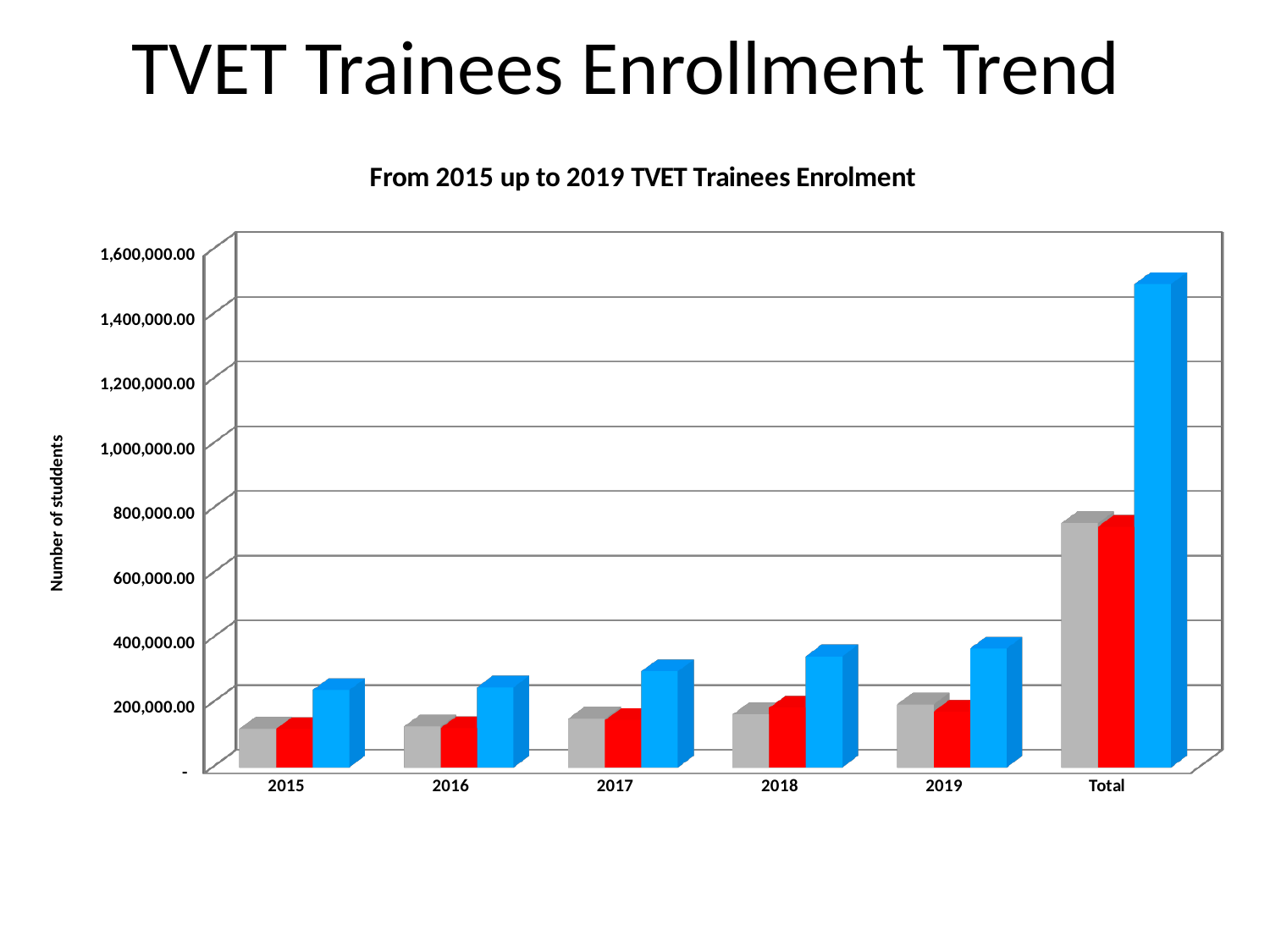
Is the value of the gray bar for 2015 greater or less than 200,000.00? less How many bars are plotted for each category on the chart? 3 How many categories are shown along the x axis of the chart? 6 What kind of chart is shown on the slide? bar chart Do the blue bars rise or fall from 2015 to 2019? rise What is the label on the vertical axis of the chart? Number of studdents Among the years 2015 to 2019, which year has the tallest blue bar? 2019 Is the value of the gray bar for Total greater or less than 600,000.00? greater What is the title of the chart? From 2015 up to 2019 TVET Trainees Enrolment Is the value of the blue bar for Total greater or less than 1,400,000.00? greater Which category has the tallest blue bar? Total